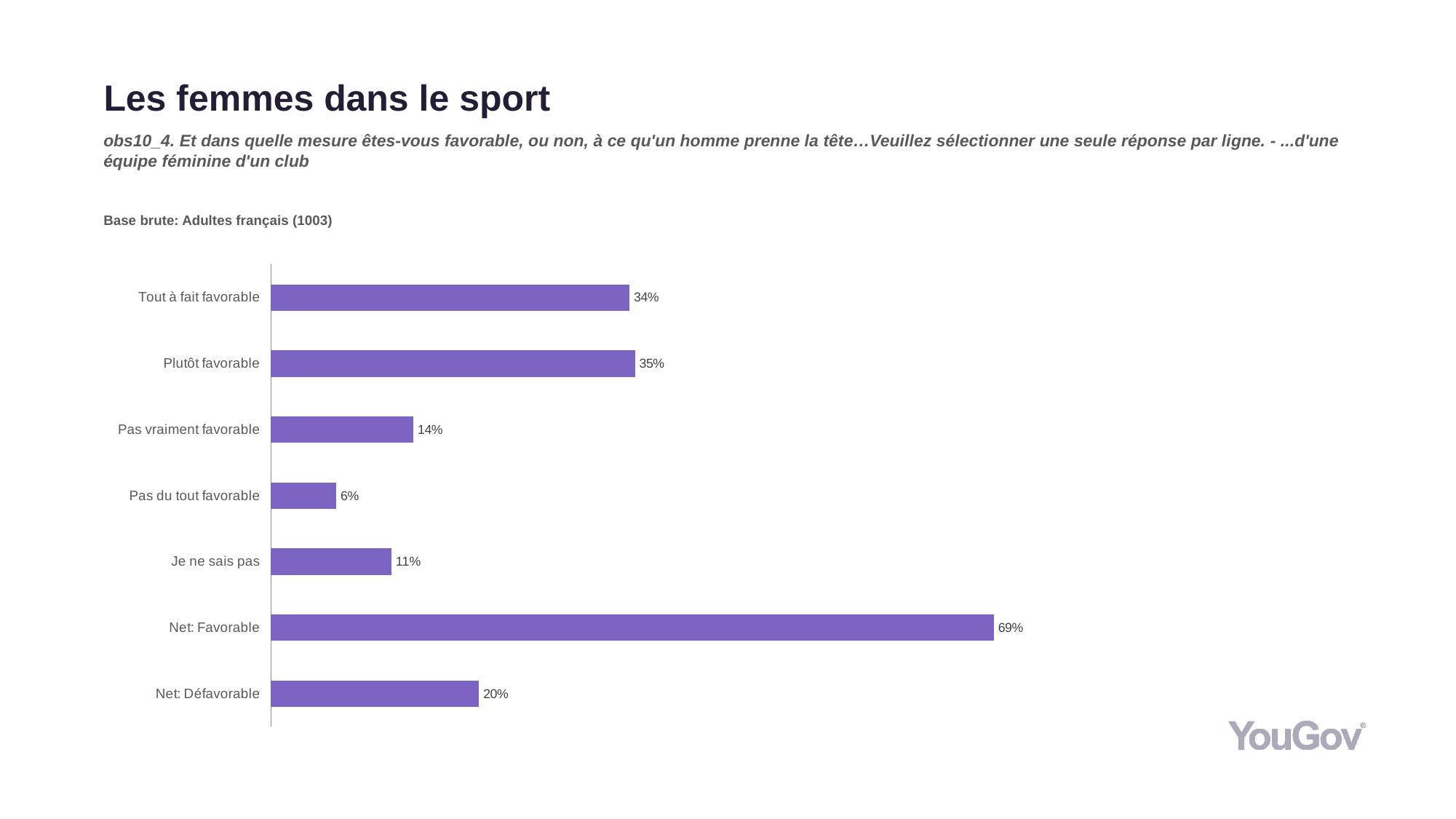
Which is larger, "Pas vraiment favorable" or "Je ne sais pas"? Pas vraiment favorable What is the value for "Plutôt favorable"? 35% What kind of chart is shown on the slide? Bar chart What is the value for "Pas du tout favorable"? 6% What is the value for "Tout à fait favorable"? 34% What is the value for "Je ne sais pas"? 11% What is the value for "Pas vraiment favorable"? 14% What is the difference between "Net: Favorable" and "Net: Défavorable"? 49 percentage points What is the value for "Net: Défavorable"? 20% Which category has the highest value? Net: Favorable Which category has the lowest value? Pas du tout favorable How many categories are shown in the chart? 7